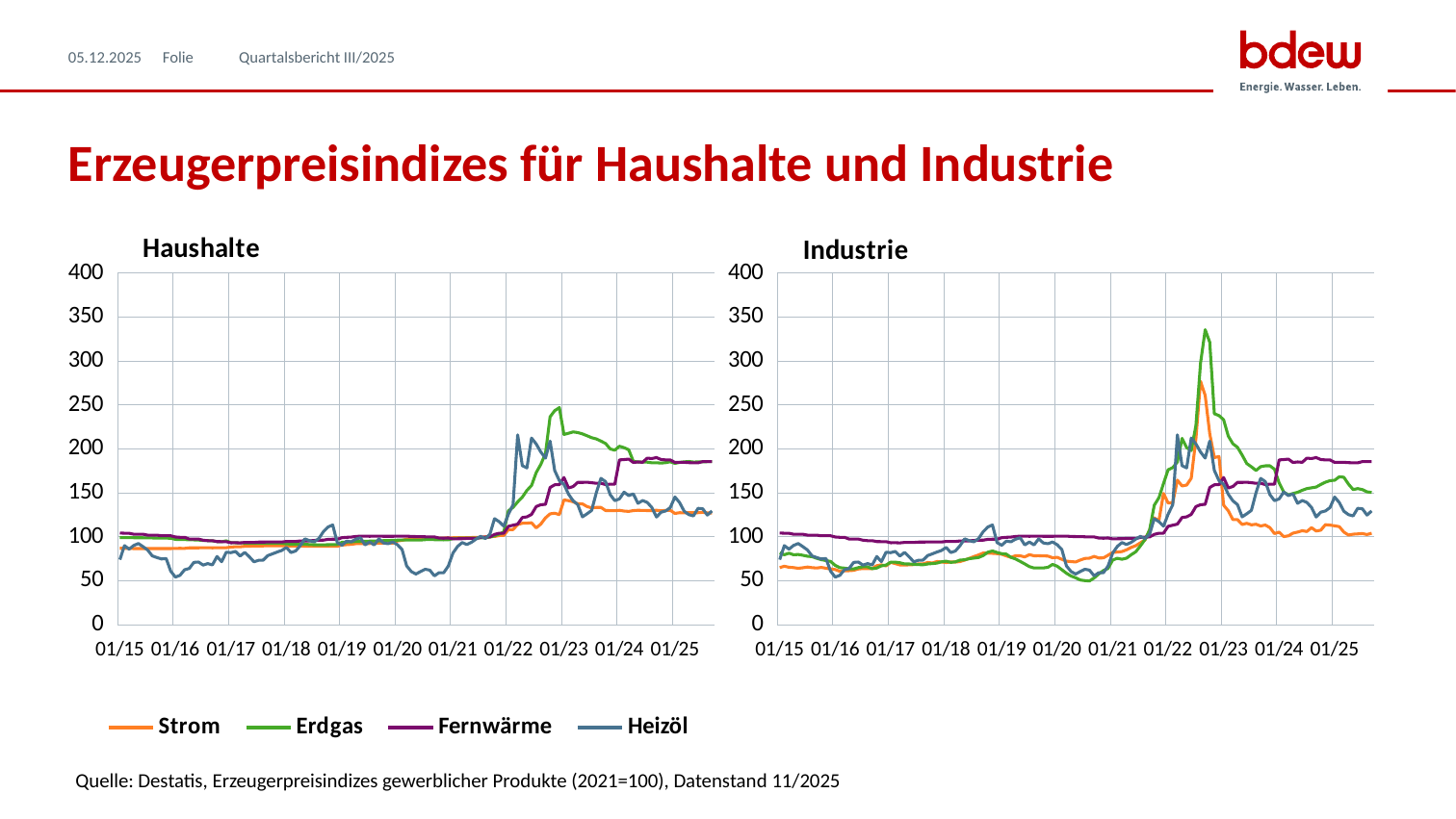
In the Haushalte chart, is the value of Heizöl around 01/16 greater or less than 100? less In the Industrie chart, which series has the higher peak, Erdgas or Strom? Erdgas Which series are listed in the legend? Strom, Erdgas, Fernwärme, Heizöl In the Industrie chart, is the peak value of Strom greater or less than 250? greater In the Haushalte chart, does the Fernwärme line rise or fall between 01/21 and 01/23? rise In the Haushalte chart, is the peak value of Erdgas greater or less than 200? greater What kind of chart is the Haushalte chart? line chart How many series does the legend list? 4 What are the titles of the two charts on the slide? Haushalte and Industrie In the Haushalte chart, which series reaches the highest peak? Erdgas In the Industrie chart, which series reaches the highest peak? Erdgas